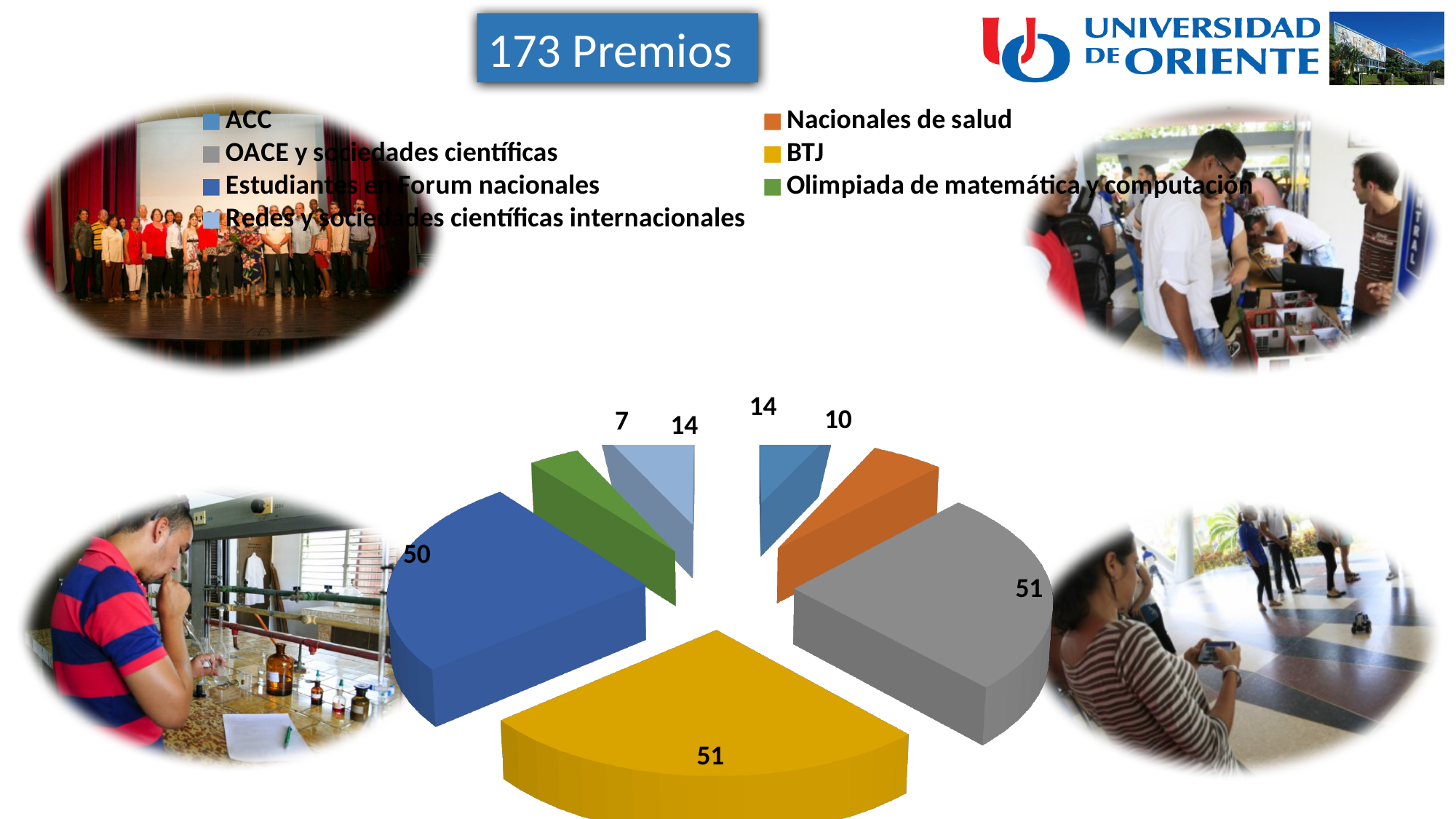
What value is shown for BTJ in the pie chart? 51 What is the difference between the values for BTJ and Nacionales de salud? 41 What value is shown for OACE y sociedades científicas? 51 What value is shown for Olimpiada de matemática y computación? 7 Which category has the smallest slice in the pie chart? Olimpiada de matemática y computación Which is larger, the value for Estudiantes en Forum nacionales or the value for Olimpiada de matemática y computación? Estudiantes en Forum nacionales What value is shown for ACC? 14 What value is shown for Estudiantes en Forum nacionales? 50 What is the title shown at the top of the slide? 173 Premios What kind of chart is shown on the slide? Pie chart What value is shown for Nacionales de salud? 10 How many categories does the pie chart show? 7